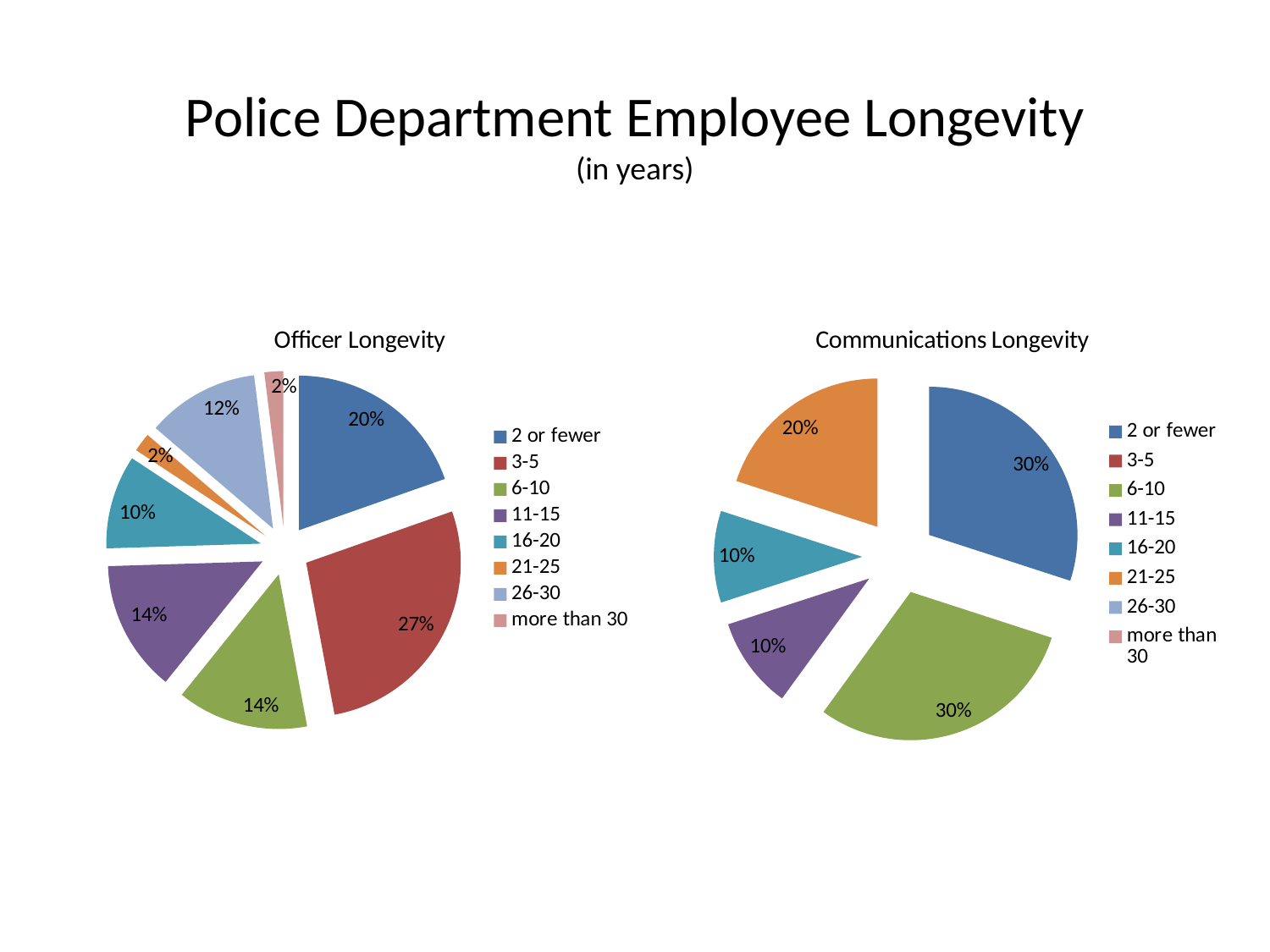
In the Communications Longevity chart, what share is shown for the 21-25 years category? 20% In the Communications Longevity chart, which is larger: the 2 or fewer share or the 21-25 share? 2 or fewer In the Communications Longevity chart, what is the combined share of the 2 or fewer and 6-10 categories? 60% In the Officer Longevity chart, what share of officers have 3-5 years of longevity? 27% In the Communications Longevity chart, what percentage is shown for the 11-15 years category? 10% In the Communications Longevity chart, how many slices are plotted in the pie? 5 In the Officer Longevity chart, which category has the largest share? 3-5 In the Officer Longevity chart, what percentage is shown for the 26-30 years category? 12% How many entries does the legend of the Officer Longevity chart list? 8 In the Officer Longevity chart, what is the difference between the 3-5 share and the 2 or fewer share? 7% What type of chart is used for Officer Longevity? Pie chart In the Officer Longevity chart, which is larger: the 16-20 share or the 26-30 share? 26-30